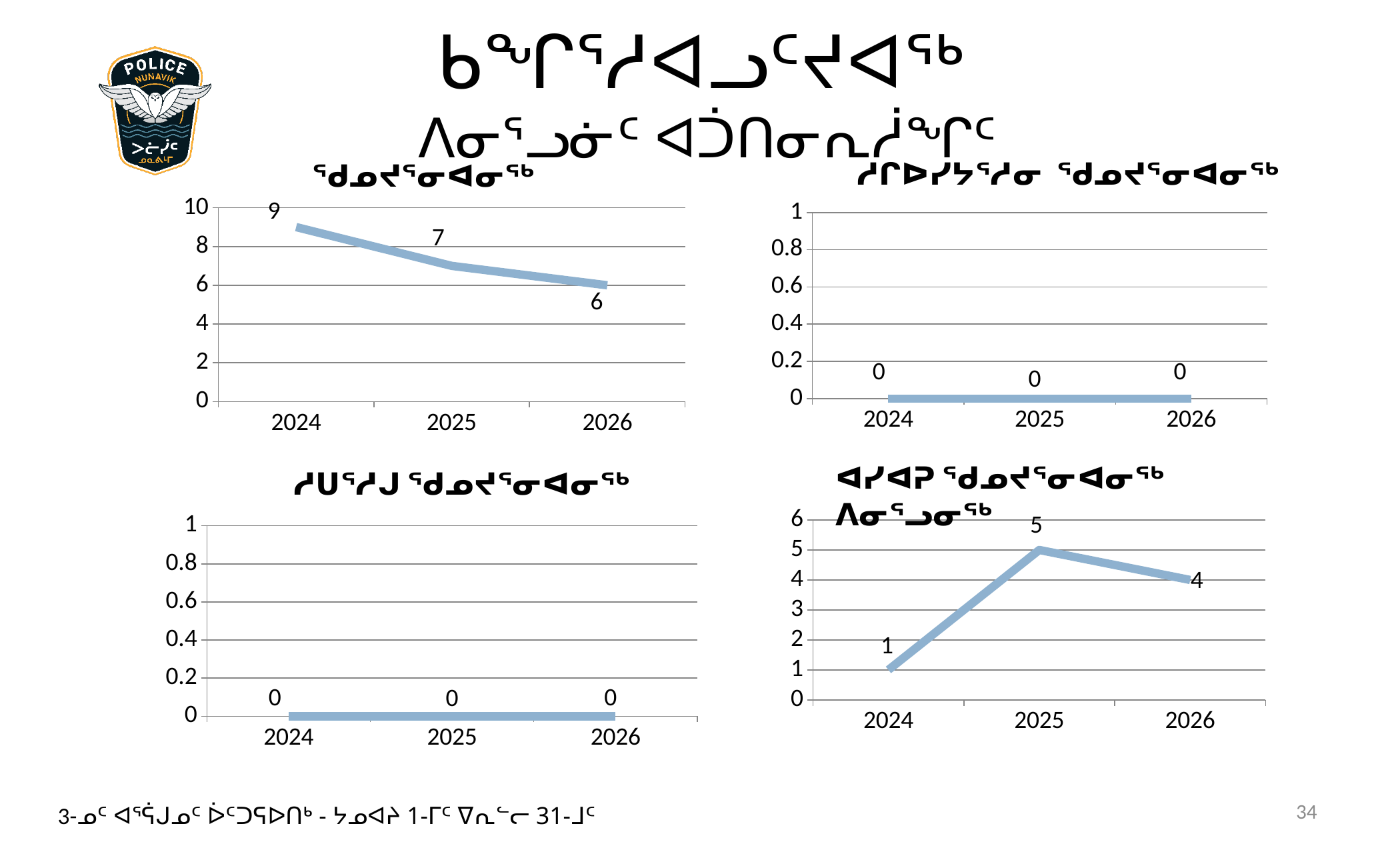
In the top-left chart, what is the value for 2026? 6 In the bottom-right chart, which year has the lowest value? 2024 What kind of chart is the top-left chart? line chart In the bottom-right chart, what is the difference between the 2025 and 2026 values? 1 In the bottom-right chart, what is the value for 2025? 5 In the bottom-left chart, what is the value for 2026? 0 In the top-right chart, what is the value for 2025? 0 In the top-left chart, do the values rise or fall from 2024 to 2026? fall In the top-left chart, what is the difference between the 2024 and 2025 values? 2 In the top-left chart, which year has the highest value? 2024 How many years are shown on the x axis of the bottom-right chart? 3 In the top-left chart, what is the value for 2024? 9